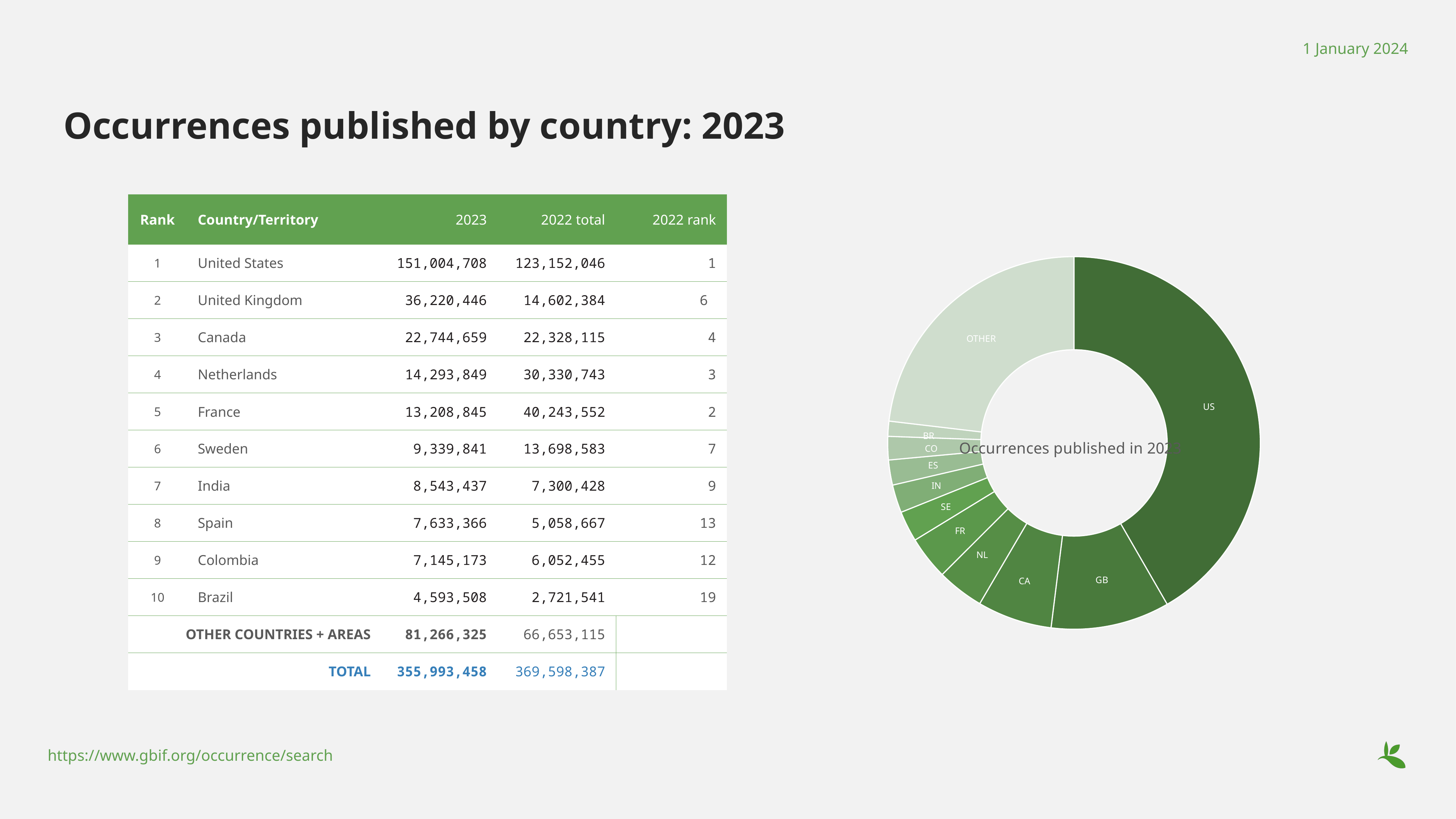
In the donut chart, which slice is larger, GB or CA? GB What is the title shown in the centre of the donut chart? Occurrences published in 2023 In the donut chart, which slice is larger, OTHER or US? US Which labelled country slice of the donut chart is the smallest? BR What is the total number of 2023 occurrences represented by the whole donut chart? 355,993,458 How many slices does the donut chart have? 11 According to the slide, how many occurrences does the OTHER slice of the donut chart represent for 2023? 81,266,325 According to the slide, how many occurrences does the GB slice of the donut chart represent for 2023? 36,220,446 Which slice of the donut chart is the largest? US What kind of chart is shown on the right of the slide? donut chart What is the difference in 2023 occurrences between the US and GB slices of the donut chart? 114,784,262 According to the slide, how many occurrences does the US slice of the donut chart represent for 2023? 151,004,708